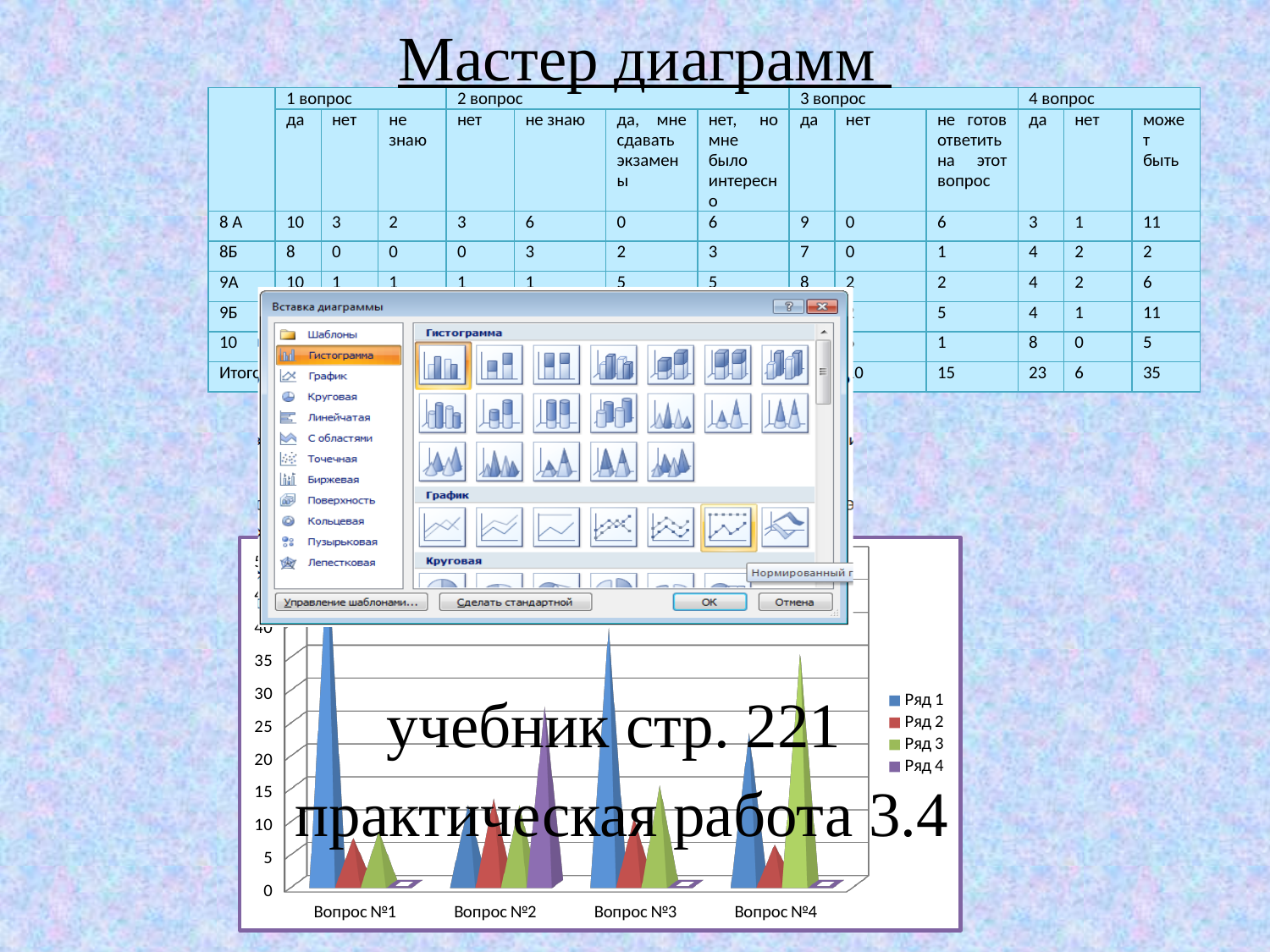
Which series has the highest value for Вопрос №1? Ряд 1 What is the label of the last category on the x axis of the chart? Вопрос №4 Is the value of Ряд 1 for Вопрос №2 greater or less than 20? less Which is larger for Ряд 1: the value for Вопрос №2 or the value for Вопрос №3? Вопрос №3 What are the legend entries of the chart? Ряд 1, Ряд 2, Ряд 3, Ряд 4 How many categories are shown on the x axis of the chart? 4 How many series does the chart legend list? 4 Is the value of Ряд 4 for Вопрос №2 greater or less than 15? greater Is the value of Ряд 1 for Вопрос №3 greater or less than 30? greater Which series has the highest value for Вопрос №4? Ряд 3 What kind of chart is shown at the bottom of the slide? bar chart